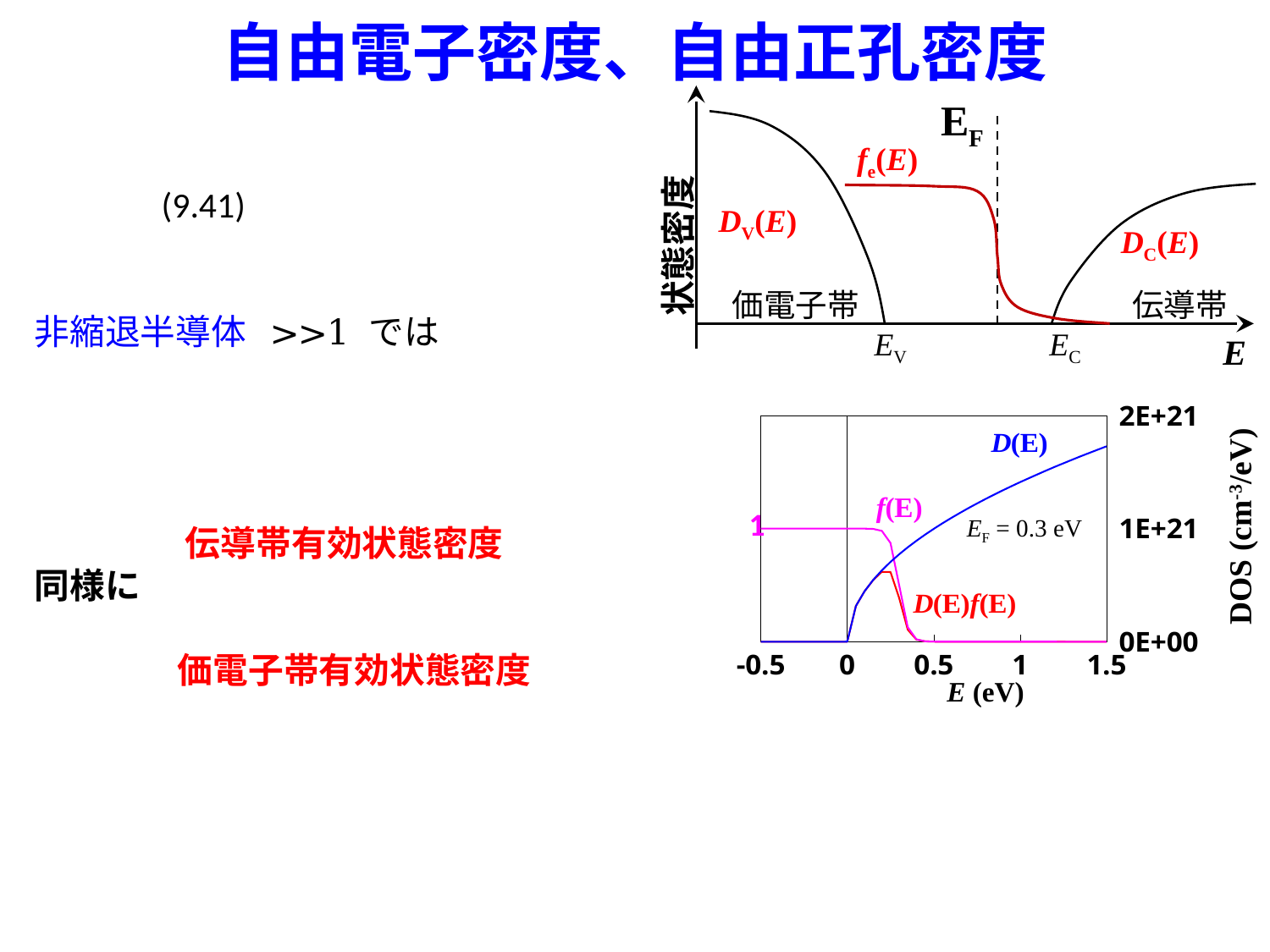
In the bottom chart, what is the label on the horizontal axis? E (eV) What kind of chart is the bottom chart (DOS versus E)? line chart In the top chart, what is the label on the vertical axis? 状態密度 In the top chart, does D_C(E) rise or fall as E increases beyond E_C? rises In the bottom chart, which curve has the highest value at E = 1.5 eV? D(E) In the bottom chart, what value of the Fermi energy E_F is printed on the plot? E_F = 0.3 eV In the bottom chart, what is the highest tick value shown on the DOS axis? 2E+21 In the bottom chart, does D(E) rise or fall as E increases from 0 to 1.5 eV? rises In the bottom chart, what is the value of f(E) at E = -0.5 eV, as labelled on the plot? 1 In the bottom chart, how many curves are plotted? 3 In the bottom chart, is the value of D(E) at E = 1 eV greater or less than 1E+21? greater In the bottom chart, is the value of D(E) at E = 1.5 eV greater or less than 1E+21? greater